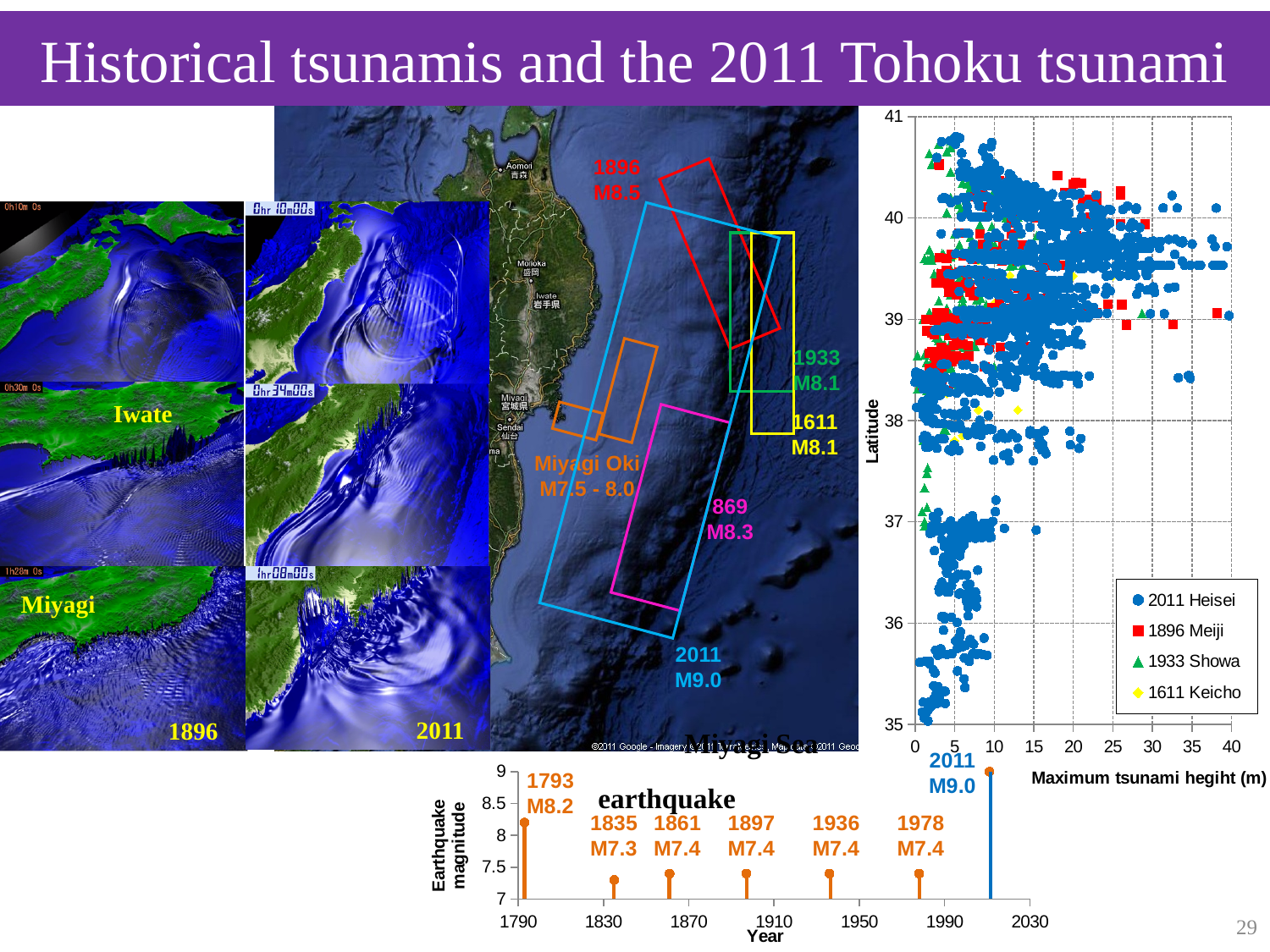
In the earthquake magnitude chart at the bottom, which earthquake had the larger magnitude, 1793 or 1835? 1793 In the scatter chart on the right, what is the label of the horizontal axis? Maximum tsunami hegiht (m) In the earthquake magnitude chart at the bottom, what is the difference in magnitude between the 2011 and 1793 earthquakes? 0.8 In the earthquake magnitude chart at the bottom, which year has the lowest earthquake magnitude? 1835 In the earthquake magnitude chart at the bottom, is the magnitude of the 2011 earthquake greater or less than 8.5? greater In the earthquake magnitude chart at the bottom, what is the magnitude of the 1835 earthquake? M7.3 In the earthquake magnitude chart at the bottom, what is the magnitude of the 1793 earthquake? M8.2 In the scatter chart on the right, how many series does the legend list? 4 In the earthquake magnitude chart at the bottom, what is the magnitude of the 2011 earthquake? M9.0 What kind of chart is the chart on the right showing latitude against maximum tsunami height? scatter chart In the earthquake magnitude chart at the bottom, which year has the highest earthquake magnitude? 2011 In the earthquake magnitude chart at the bottom, how many earthquakes are plotted? 7